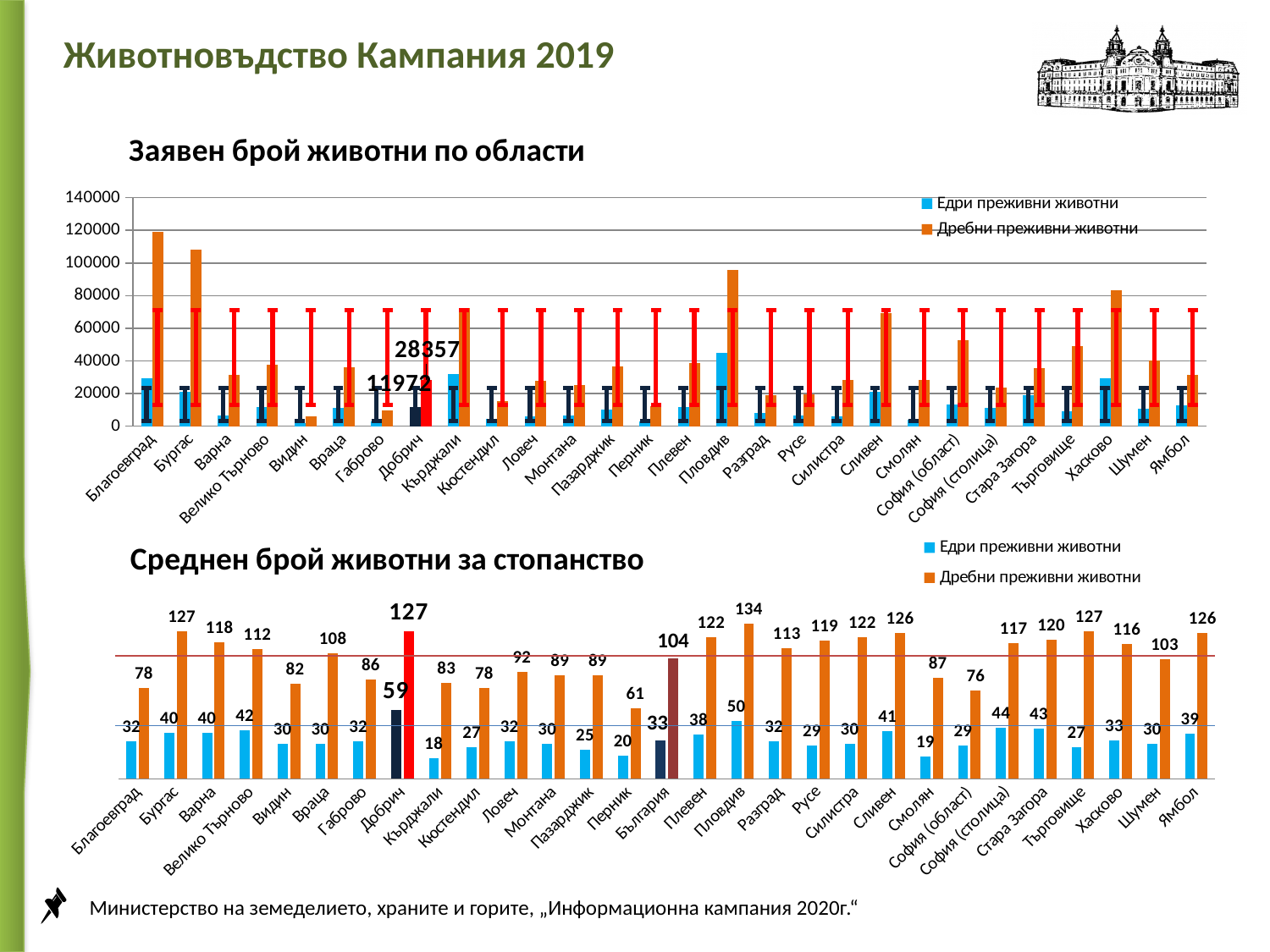
In the chart 'Среднен брой животни за стопанство', which is larger for Дребни преживни животни: Варна or Велико Търново? Варна In the chart 'Заявен брой животни по области', how many series does the legend list? 2 In the chart 'Среднен брой животни за стопанство', which category has the lowest value for Дребни преживни животни? Перник In the chart 'Заявен брой животни по области', is the value for Дребни преживни животни in Благоевград greater or less than 100000? greater In the chart 'Среднен брой животни за стопанство', what is the value for Едри преживни животни in България? 33 In the chart 'Заявен брой животни по области', what is the value for Едри преживни животни in Добрич? 11972 In the chart 'Среднен брой животни за стопанство', what is the value for Дребни преживни животни in Пловдив? 134 In the chart 'Среднен брой животни за стопанство', which category has the highest value for Едри преживни животни? Добрич What kind of chart is 'Среднен брой животни за стопанство'? bar chart In the chart 'Среднен брой животни за стопанство', what is the difference between Дребни преживни животни and Едри преживни животни in Добрич? 68 In the chart 'Заявен брой животни по области', what is the value for Дребни преживни животни in Добрич? 28357 In the chart 'Заявен брой животни по области', is the value for Дребни преживни животни in Видин greater or less than 20000? less